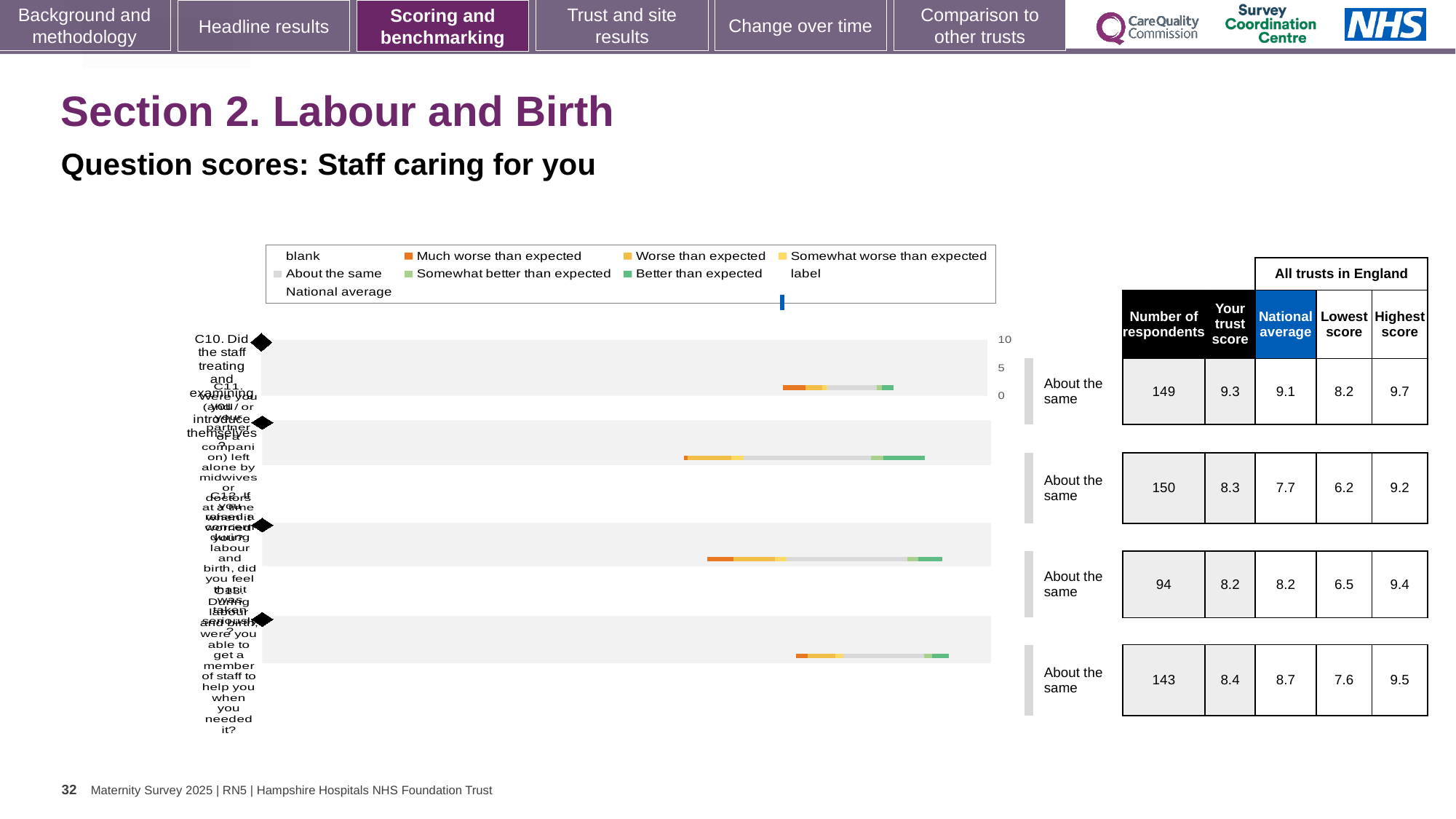
In the chart legend, what colour represents 'Much worse than expected'? orange What benchmark category is shown next to each of the four bars in the chart? About the same In the table beside the chart, what is the difference between the trust score and the national average for the row with 149 respondents? 0.2 In the table beside the chart, for the row with 143 respondents, which is larger: the trust score or the national average? national average How many question bars are plotted in the chart? 4 In the table beside the chart, what is the lowest value in the 'Lowest score' column? 6.2 In the table beside the chart, what is the national average for the row with 150 respondents? 7.7 In the table beside the chart, what is the 'Your trust score' for the row with 149 respondents? 9.3 In the table beside the chart, what is the highest score for the row with 94 respondents? 9.4 In the table beside the chart, which row has the highest 'Your trust score'? the row with 149 respondents (9.3) In the chart legend, what colour represents 'Better than expected'? green What kind of chart is shown on the slide? bar chart